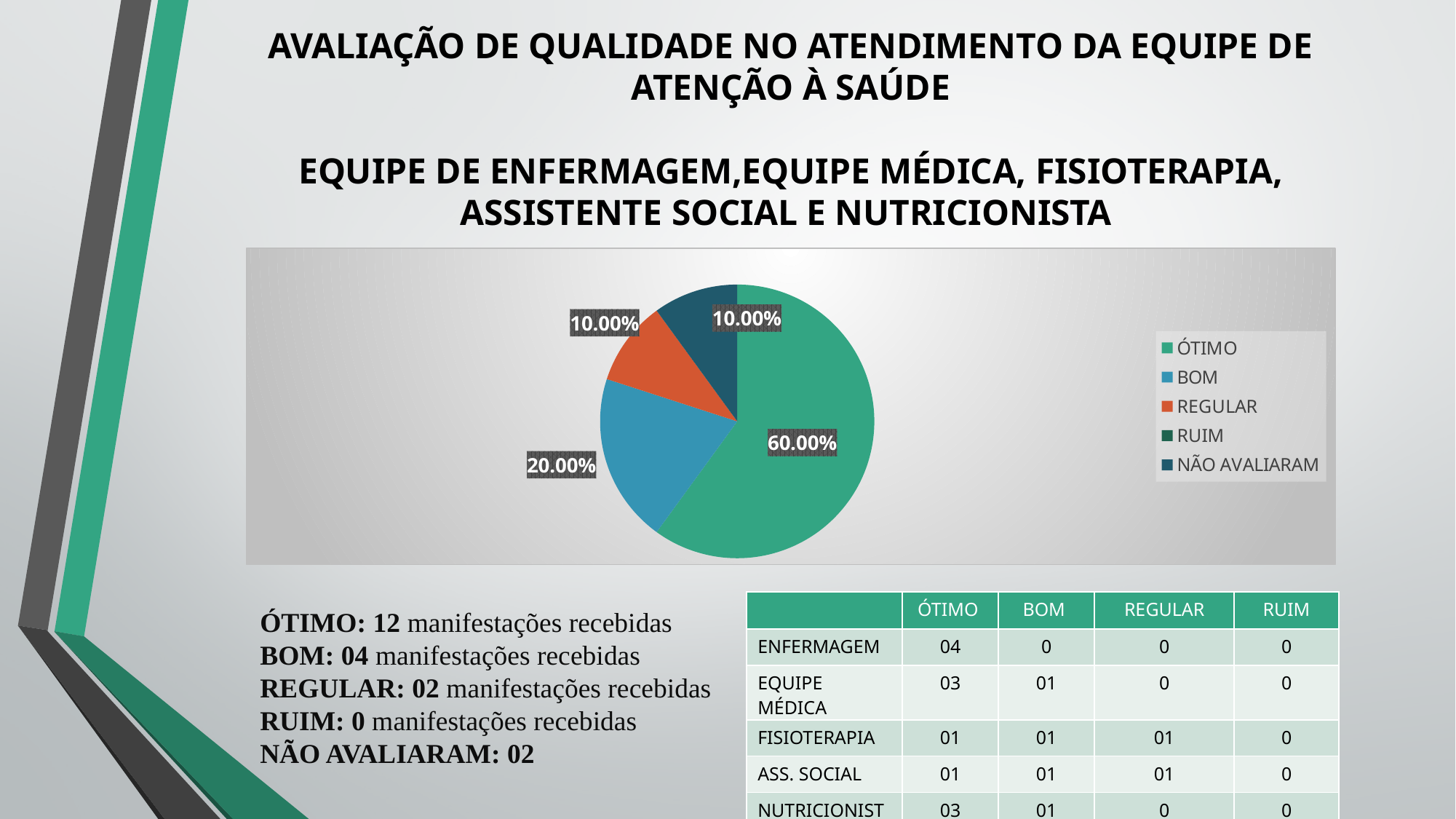
What percentage of the pie chart is labelled for REGULAR? 10.00% How many slices with data labels are visible in the pie chart? 4 What kind of chart is shown on the slide? pie chart What is the difference in percentage points between the BOM slice and the REGULAR slice? 10.00% Which slice is larger in the pie chart, BOM or REGULAR? BOM What percentage of the pie chart is labelled for NÃO AVALIARAM? 10.00% How many entries does the legend of the pie chart list? 5 What is the difference in percentage points between the ÓTIMO slice and the BOM slice? 40.00% Which category has the largest slice in the pie chart? ÓTIMO What percentage of the pie chart is labelled for BOM? 20.00% What colour is the ÓTIMO slice in the pie chart? green What percentage of the pie chart is labelled for ÓTIMO? 60.00%